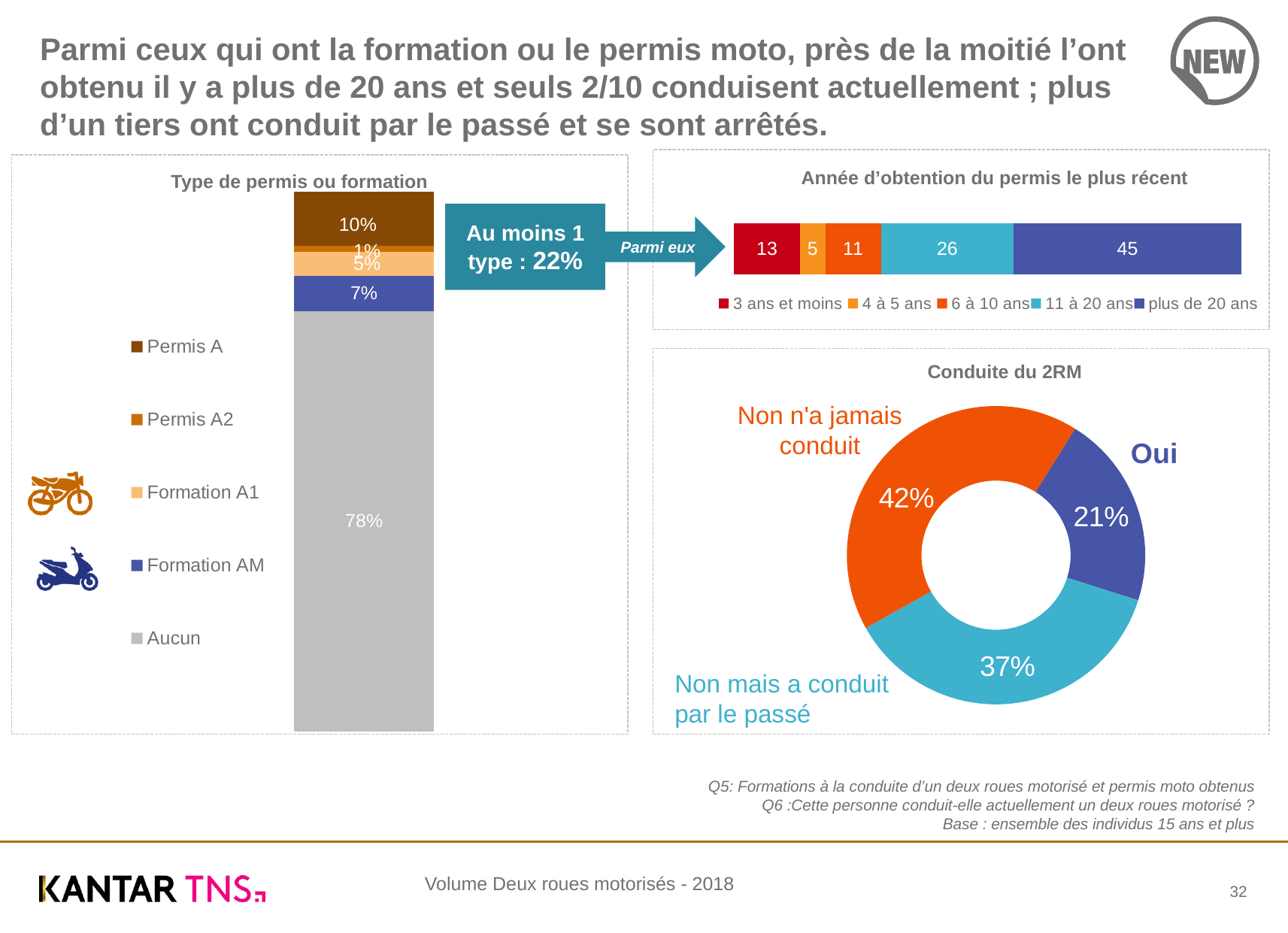
In the 'Type de permis ou formation' chart, which category has the lowest value? Permis A2 In the 'Année d'obtention du permis le plus récent' chart, what is the value for 'plus de 20 ans'? 45 In the 'Conduite du 2RM' chart, what share is 'Oui'? 21% In the 'Année d'obtention du permis le plus récent' chart, which is larger: '3 ans et moins' or '6 à 10 ans'? 3 ans et moins In the 'Type de permis ou formation' chart, what is the value for Aucun? 78% In the 'Type de permis ou formation' chart, what is the difference between Formation AM and Formation A1? 2% In the 'Conduite du 2RM' chart, which category has the largest share? Non n'a jamais conduit In the 'Type de permis ou formation' chart, how many entries does the legend list? 5 In the 'Année d'obtention du permis le plus récent' chart, which category has the highest value? plus de 20 ans In the 'Année d'obtention du permis le plus récent' chart, what is the total of all segments in the bar? 100 What kind of chart is 'Conduite du 2RM'? Donut chart In the 'Type de permis ou formation' chart, what is the value for Permis A? 10%